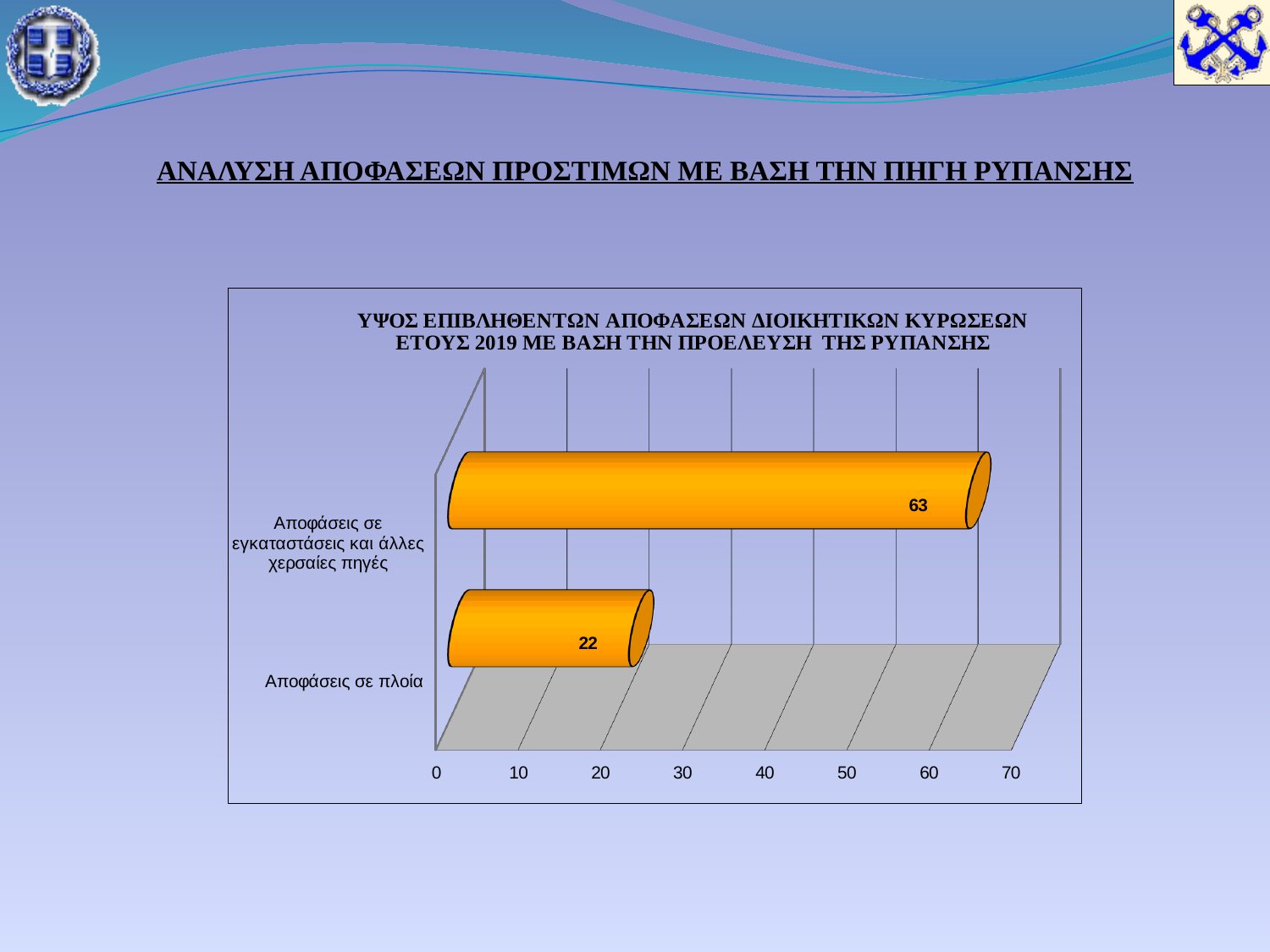
What is the title of the chart? ΥΨΟΣ ΕΠΙΒΛΗΘΕΝΤΩΝ ΑΠΟΦΑΣΕΩΝ ΔΙΟΙΚΗΤΙΚΩΝ ΚΥΡΩΣΕΩΝ ΕΤΟΥΣ 2019 ΜΕ ΒΑΣΗ ΤΗΝ ΠΡΟΕΛΕΥΣΗ ΤΗΣ ΡΥΠΑΝΣΗΣ Is the value for "Αποφάσεις σε πλοία" greater or less than 30? less What is the value for "Αποφάσεις σε πλοία"? 22 What is the value for "Αποφάσεις σε εγκαταστάσεις και άλλες χερσαίες πηγές"? 63 Which category has the lowest value? Αποφάσεις σε πλοία What is the maximum value shown on the horizontal axis of the chart? 70 How many categories are shown in the chart? 2 Which category has the highest value? Αποφάσεις σε εγκαταστάσεις και άλλες χερσαίες πηγές What is the difference between the value for "Αποφάσεις σε εγκαταστάσεις και άλλες χερσαίες πηγές" and the value for "Αποφάσεις σε πλοία"? 41 Is the value for "Αποφάσεις σε εγκαταστάσεις και άλλες χερσαίες πηγές" greater or less than 50? greater What kind of chart is shown on the slide? bar chart Which is larger: the value for "Αποφάσεις σε πλοία" or the value for "Αποφάσεις σε εγκαταστάσεις και άλλες χερσαίες πηγές"? Αποφάσεις σε εγκαταστάσεις και άλλες χερσαίες πηγές